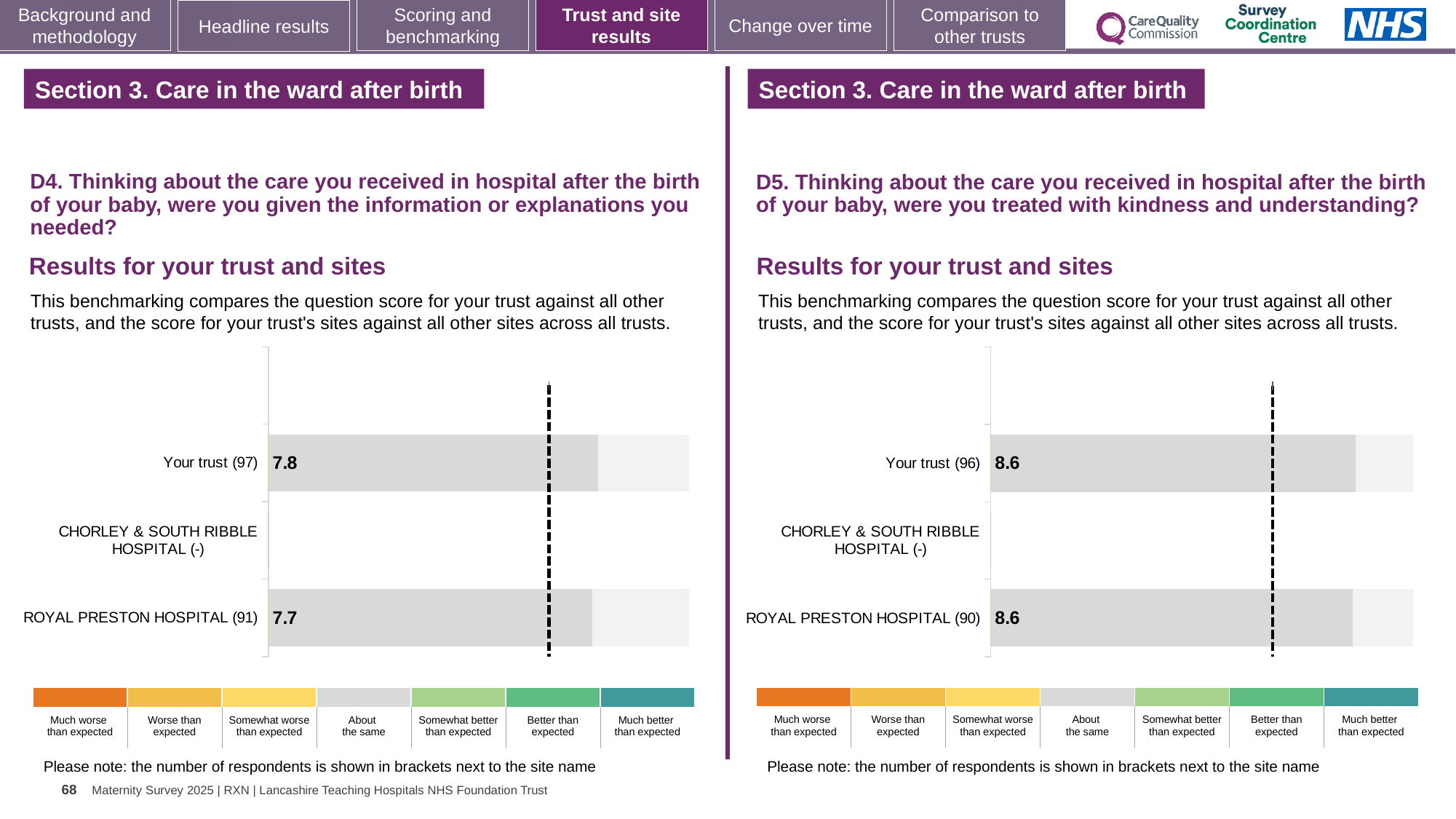
What kind of chart is used in the D4 chart on the left? Bar chart In the D4 chart on the left, what is the score for Your trust? 7.8 In the D4 chart on the left, what is the score for ROYAL PRESTON HOSPITAL? 7.7 In the D5 chart on the right, what is the score for ROYAL PRESTON HOSPITAL? 8.6 In the D4 chart on the left, what is the difference between the score for Your trust and the score for ROYAL PRESTON HOSPITAL? 0.1 In the D4 chart on the left, which site has no score bar shown? CHORLEY & SOUTH RIBBLE HOSPITAL In the D4 chart on the left, which has the higher score, Your trust or ROYAL PRESTON HOSPITAL? Your trust In the D5 chart on the right, how many respondents are shown in brackets for ROYAL PRESTON HOSPITAL? 90 In the D4 chart on the left, how many respondents are shown in brackets for Your trust? 97 How many benchmark categories are shown in the colour key below the D5 chart on the right? 7 In the D5 chart on the right, how many categories (rows) are listed on the vertical axis? 3 In the D5 chart on the right, what is the score for Your trust? 8.6